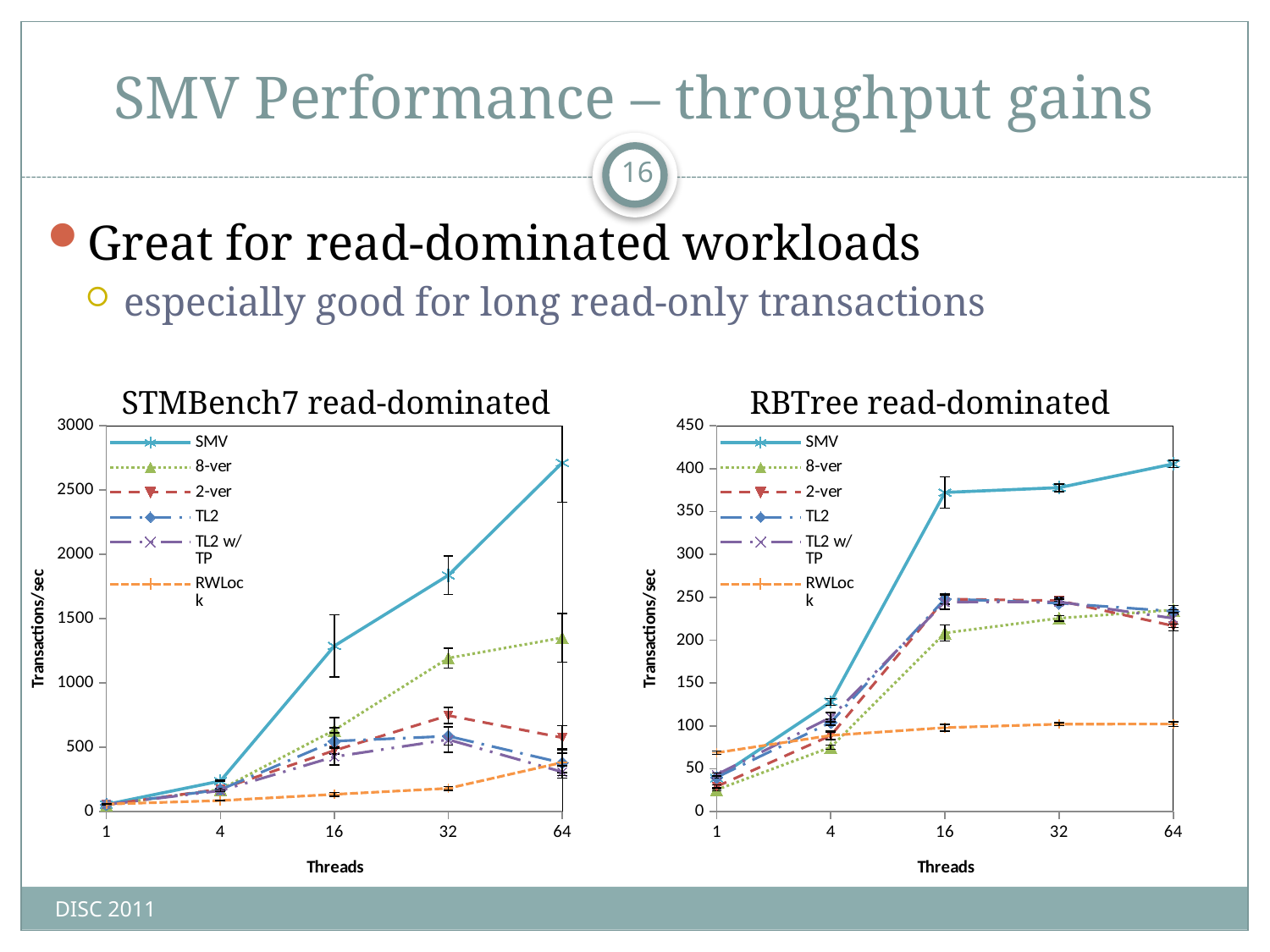
In the STMBench7 read-dominated chart, is the value for 8-ver at 64 threads greater or less than 1000? greater What is the y-axis label of the RBTree read-dominated chart? Transactions/sec In the RBTree read-dominated chart, which series has the highest value at 64 threads? SMV In the STMBench7 read-dominated chart, does the SMV series rise or fall as the number of threads increases? rises In the RBTree read-dominated chart, which is larger at 16 threads, SMV or 8-ver? SMV In the STMBench7 read-dominated chart, is the value for SMV at 64 threads greater or less than 2500? greater How many thread counts are plotted along the x axis of the STMBench7 read-dominated chart? 5 In the STMBench7 read-dominated chart, which series has the lowest value at 32 threads? RWLock In the RBTree read-dominated chart, is the value for SMV at 16 threads greater or less than 350? greater In the STMBench7 read-dominated chart, which series has the highest value at 64 threads? SMV How many series does the legend of the RBTree read-dominated chart list? 6 What kind of chart is the STMBench7 read-dominated chart? line chart